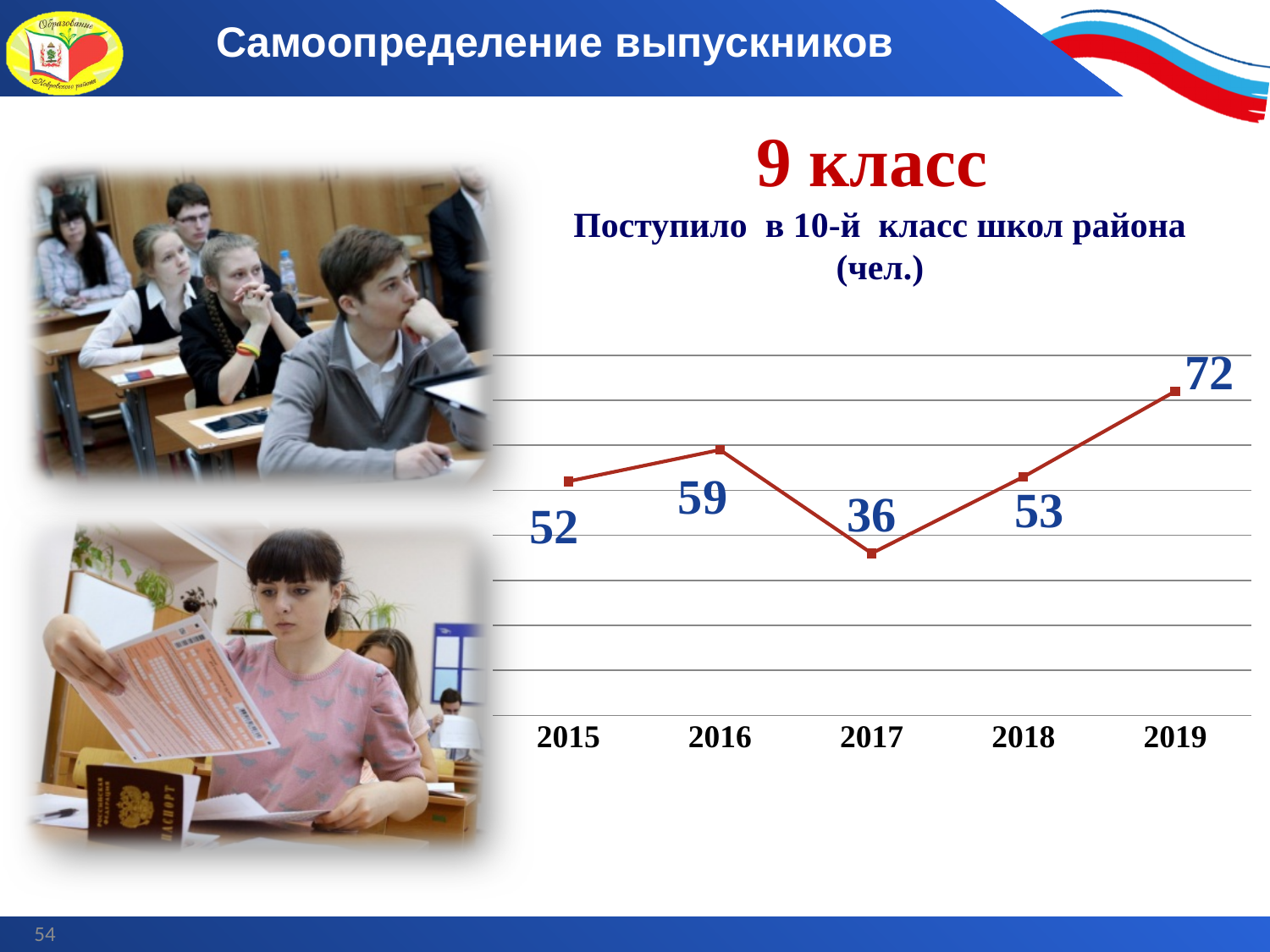
What is the difference between the values for 2016 and 2015? 7 What value is shown for 2017? 36 What is the difference between the values for 2019 and 2017? 36 Which year has the highest value? 2019 What value is shown for 2015? 52 Do the values rise or fall from 2017 to 2019? rise What value is shown for 2018? 53 Which is larger, the value for 2016 or the value for 2018? 2016 Which year has the lowest value? 2017 What value is shown for 2019? 72 How many years are plotted on the chart? 5 What kind of chart is shown? line chart